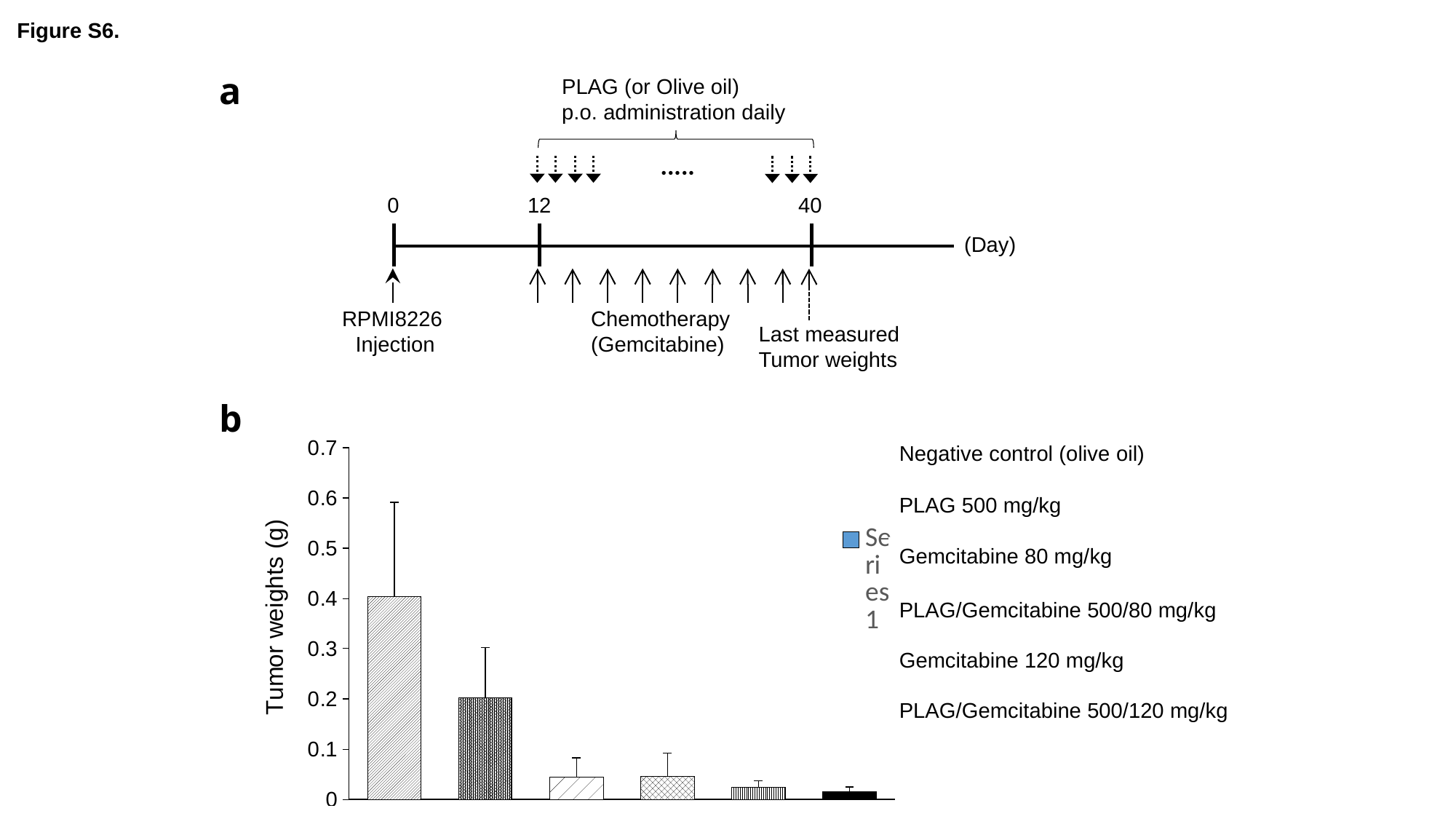
In the panel b chart, how many bars are plotted? 6 In the panel b chart, do the bar values generally rise or fall from left to right? fall In the panel b chart, is the value of the first (leftmost) bar greater or less than 0.5? less In the panel b chart, is the value of the first (leftmost) bar greater or less than 0.3? greater What kind of chart is shown in panel b? bar chart In the panel b chart, is the value of the second bar greater or less than 0.1? greater In the panel b chart, which bar is the tallest? the leftmost (first) bar What is the y-axis title of the panel b chart? Tumor weights (g) In the panel b chart, which is larger, the first bar or the second bar? the first bar In the panel b chart, which bar is the shortest? the rightmost (sixth, black) bar